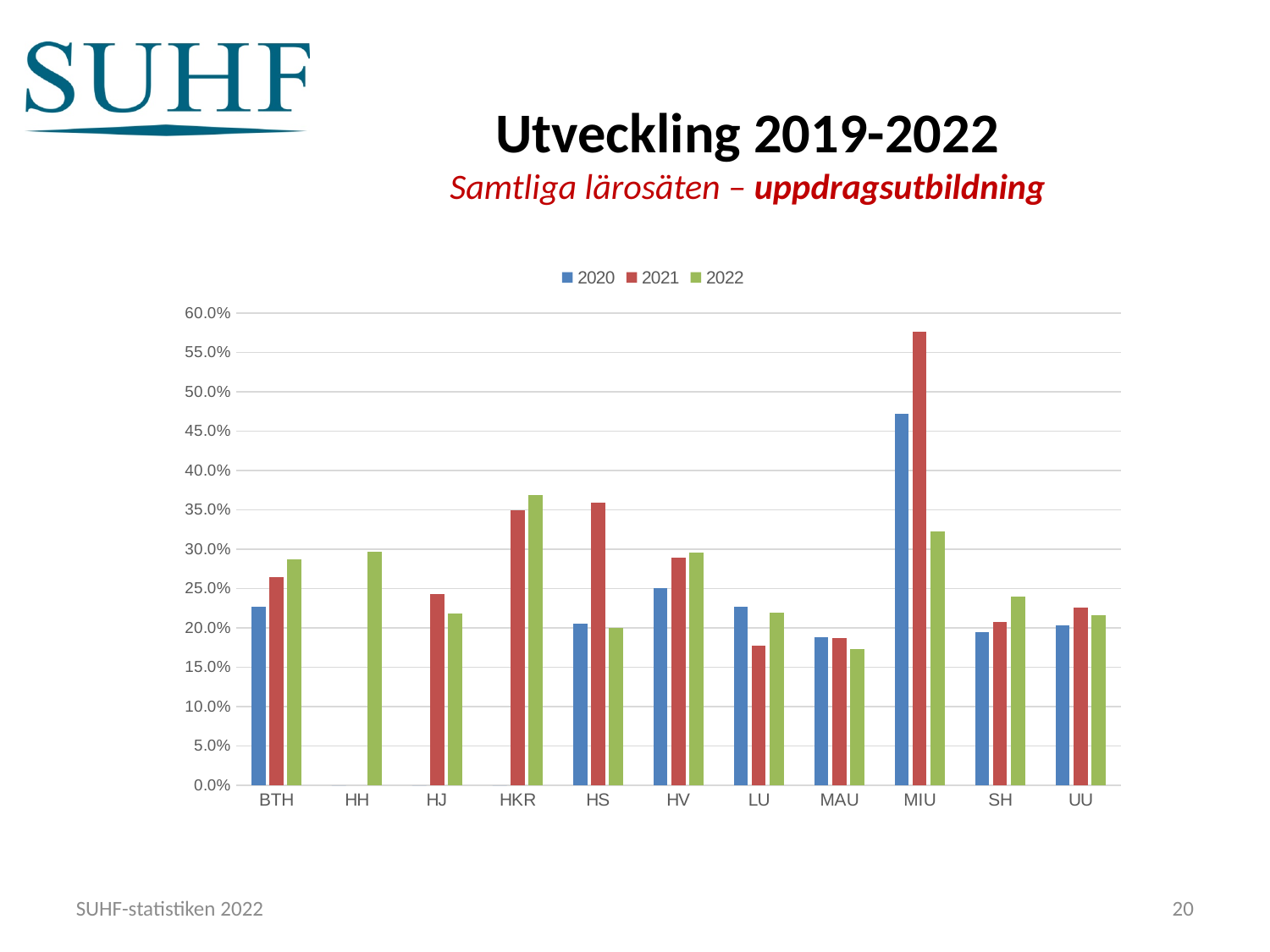
Which institution has the lowest value for 2022? MAU Do the values for BTH rise or fall from 2020 to 2022? rise How many institutions (categories) are shown on the x axis? 11 What kind of chart is shown on the slide? bar chart Which institution has the highest value for 2022? HKR For HS, which is larger: the 2021 value or the 2022 value? 2021 Is the 2022 value for MAU greater or less than 20%? less How many series does the legend list? 3 Which institution has the highest bar in the chart? MIU For MIU, which is larger: the 2020 value or the 2021 value? 2021 Is the 2021 value for MIU greater or less than 55%? greater Is the 2022 value for HKR greater or less than 35%? greater